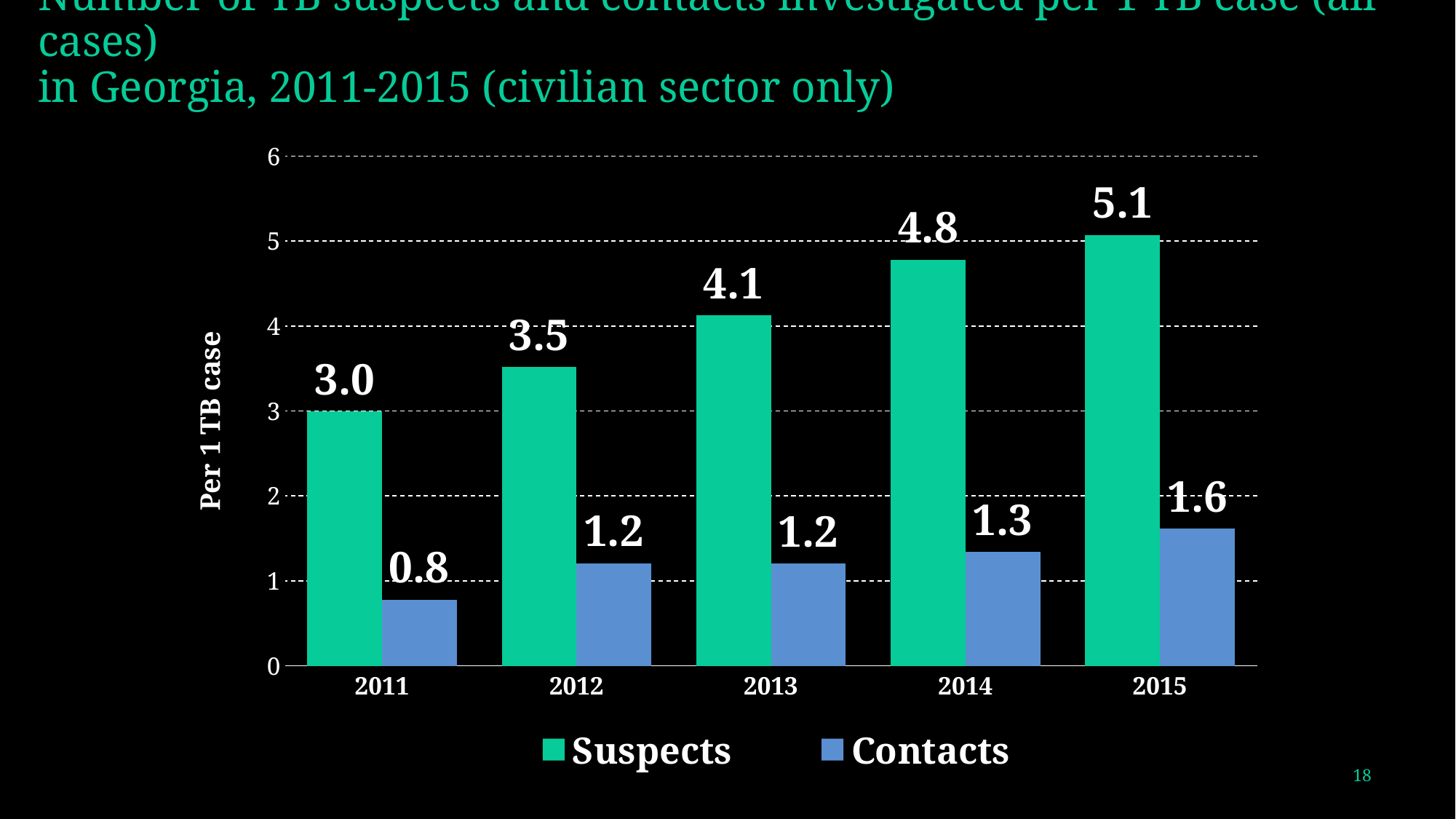
What is the value for Contacts in 2015? 1.6 What is the value for Contacts in 2011? 0.8 What kind of chart is shown on the slide? Bar chart What is the value for Suspects in 2013? 4.1 What is the difference between the Suspects and Contacts values in 2015? 3.5 In which year is the Suspects value highest? 2015 Which is larger, the Contacts value in 2014 or the Contacts value in 2012? 2014 What is the difference between the Suspects values for 2014 and 2011? 1.8 In which year is the Contacts value lowest? 2011 Do the Suspects values rise or fall from 2011 to 2015? Rise How many years are shown on the x axis? 5 How many series does the legend list? 2